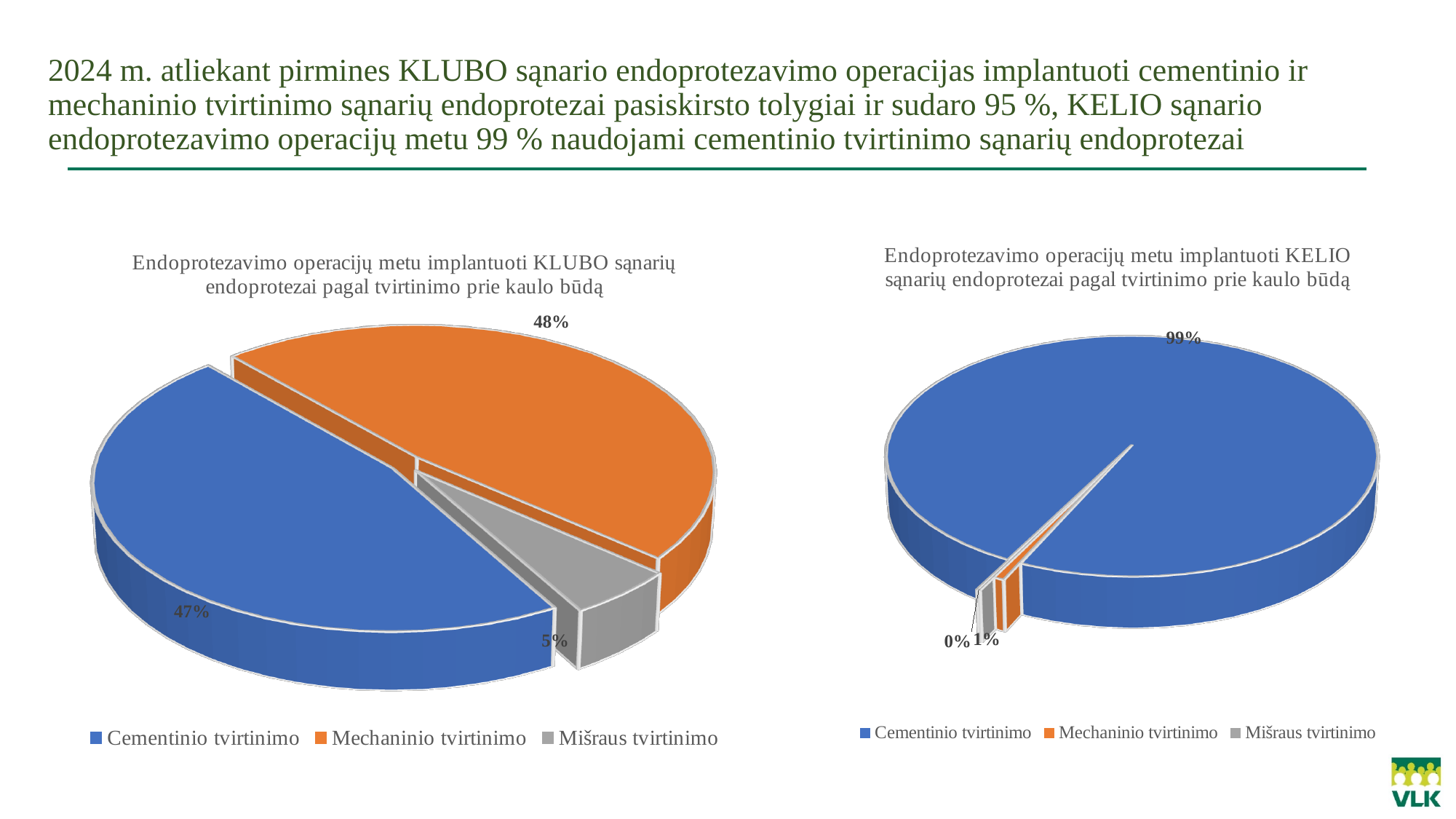
In the KLUBO chart (left), which category has the smallest share? Mišraus tvirtinimo In the KELIO chart (right), which category has the largest share? Cementinio tvirtinimo What type of chart is used on the right side of the slide (KELIO)? Pie chart In the KLUBO chart (left), what is the difference between the Mechaninio tvirtinimo and Cementinio tvirtinimo shares? 1% In the KLUBO chart (left), what share is labelled for Cementinio tvirtinimo? 47% How many entries does the legend of the KLUBO chart (left) list? 3 In the KELIO chart (right), what share is labelled for Mišraus tvirtinimo? 0% In the KELIO chart (right), what share is labelled for Cementinio tvirtinimo? 99% In the KLUBO chart (left), what share is labelled for Mišraus tvirtinimo? 5% In the KELIO chart (right), what share is labelled for Mechaninio tvirtinimo? 1% In the KLUBO chart (left), what share is labelled for Mechaninio tvirtinimo? 48% In the KLUBO chart (left), which is larger according to the labels: Mechaninio tvirtinimo or Cementinio tvirtinimo? Mechaninio tvirtinimo